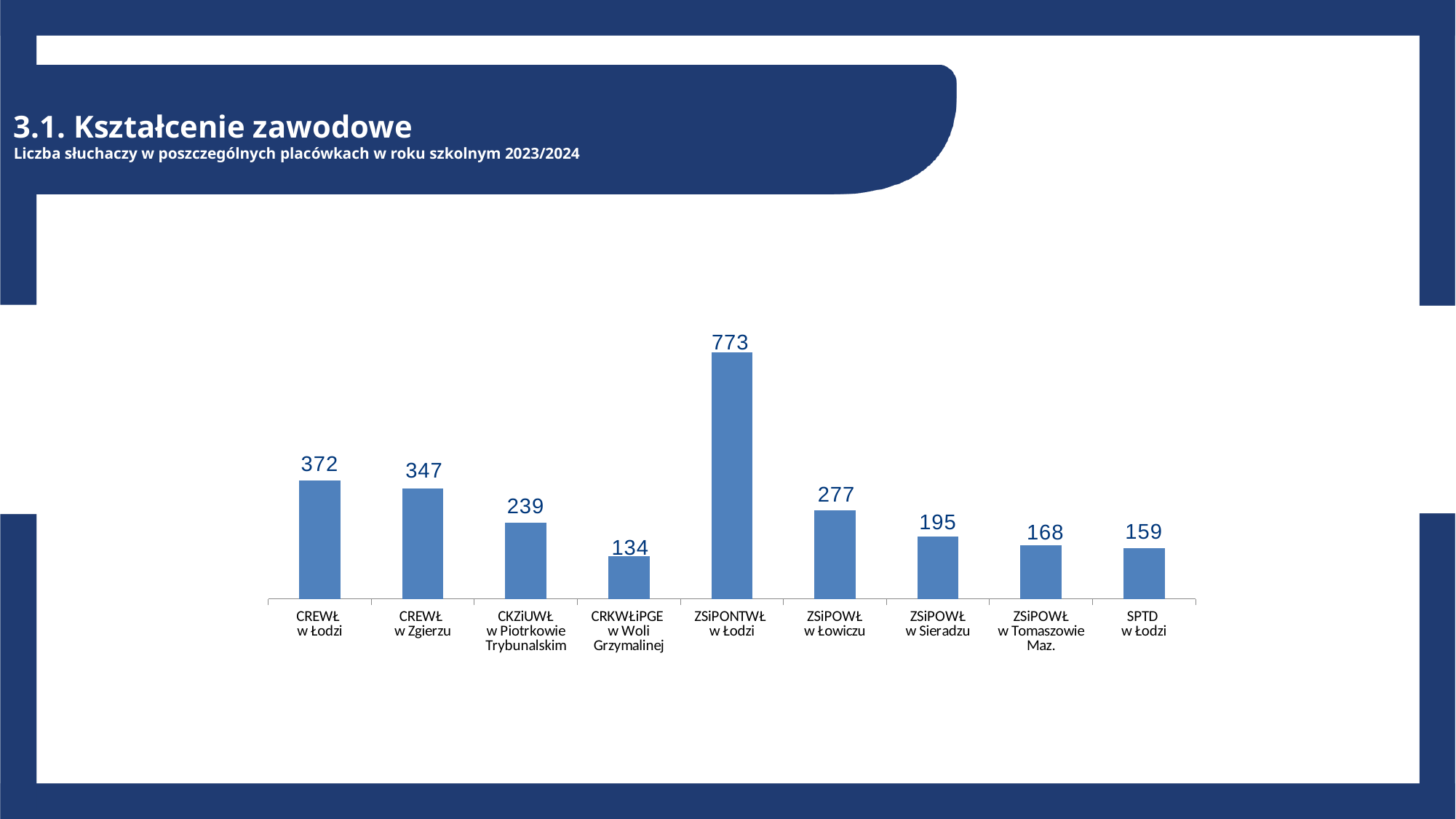
What is the subtitle describing the chart on the slide? Liczba słuchaczy w poszczególnych placówkach w roku szkolnym 2023/2024 Which is larger, the value for CKZiUWŁ w Piotrkowie Trybunalskim or the value for ZSiPOWŁ w Sieradzu? CKZiUWŁ w Piotrkowie Trybunalskim What is the difference between the values for ZSiPONTWŁ w Łodzi and ZSiPOWŁ w Łowiczu? 496 What is the value for CRKWŁiPGE w Woli Grzymalinej? 134 What kind of chart is shown on the slide? bar chart What is the value for ZSiPOWŁ w Tomaszowie Maz.? 168 What is the value for ZSiPONTWŁ w Łodzi? 773 What is the difference between the values for CREWŁ w Łodzi and CREWŁ w Zgierzu? 25 How many categories are shown on the chart? 9 Which category has the lowest value? CRKWŁiPGE w Woli Grzymalinej Which category has the highest value? ZSiPONTWŁ w Łodzi What is the value for CREWŁ w Zgierzu? 347